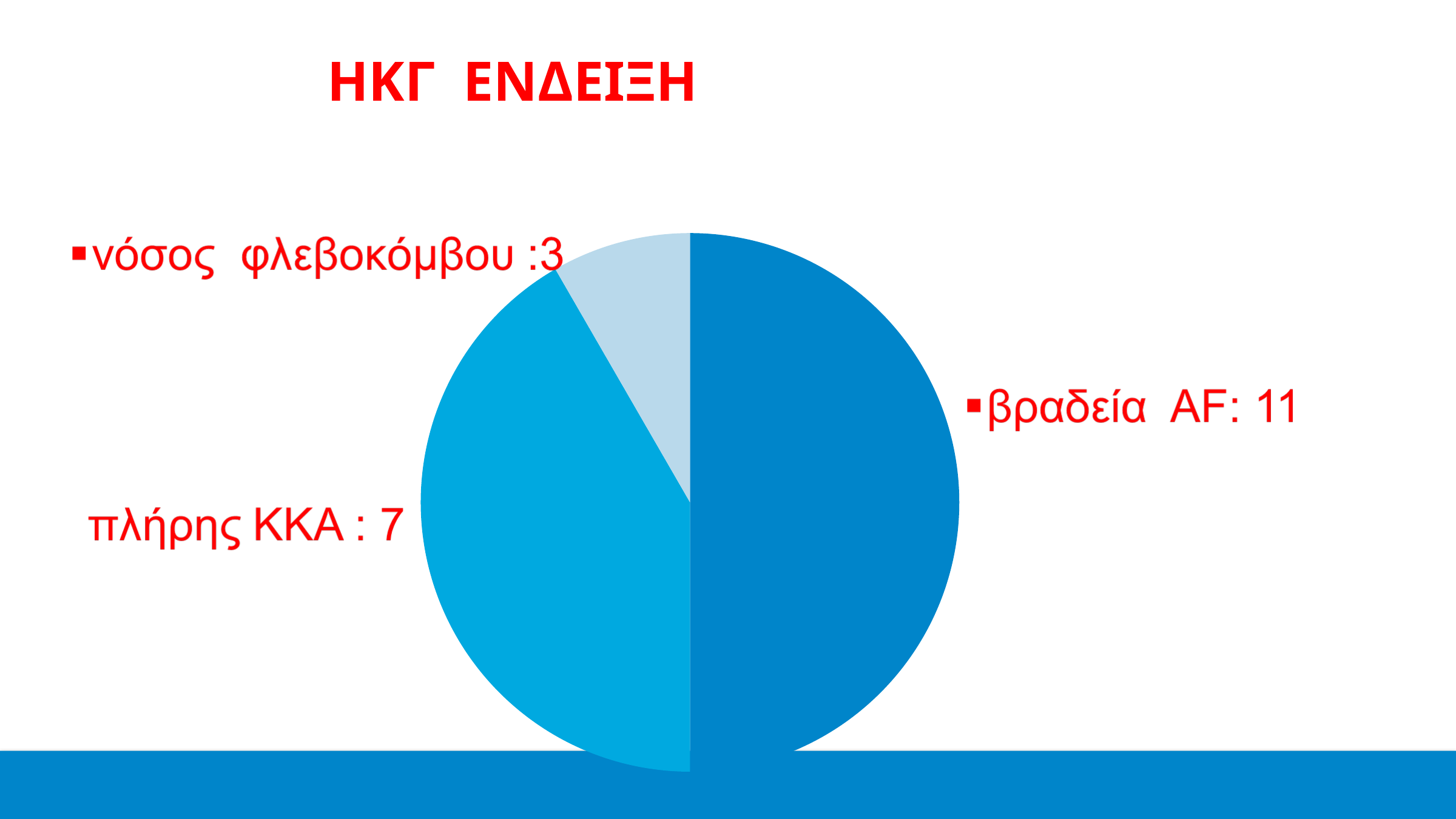
What is the total of all the values shown in the pie chart? 21 How many categories are shown in the pie chart? 3 What is the value for βραδεία AF? 11 What type of chart is shown on the slide? pie chart What is the difference between the values for πλήρης ΚΚΑ and νόσος φλεβοκόμβου? 4 Which category has the smallest slice of the pie? νόσος φλεβοκόμβου What is the value for νόσος φλεβοκόμβου? 3 What is the value for πλήρης ΚΚΑ? 7 What is the difference between the values for βραδεία AF and πλήρης ΚΚΑ? 4 Which category has the largest slice of the pie? βραδεία AF What is the title of the chart? ΗΚΓ ΕΝΔΕΙΞΗ Which is larger, the value for πλήρης ΚΚΑ or the value for νόσος φλεβοκόμβου? πλήρης ΚΚΑ